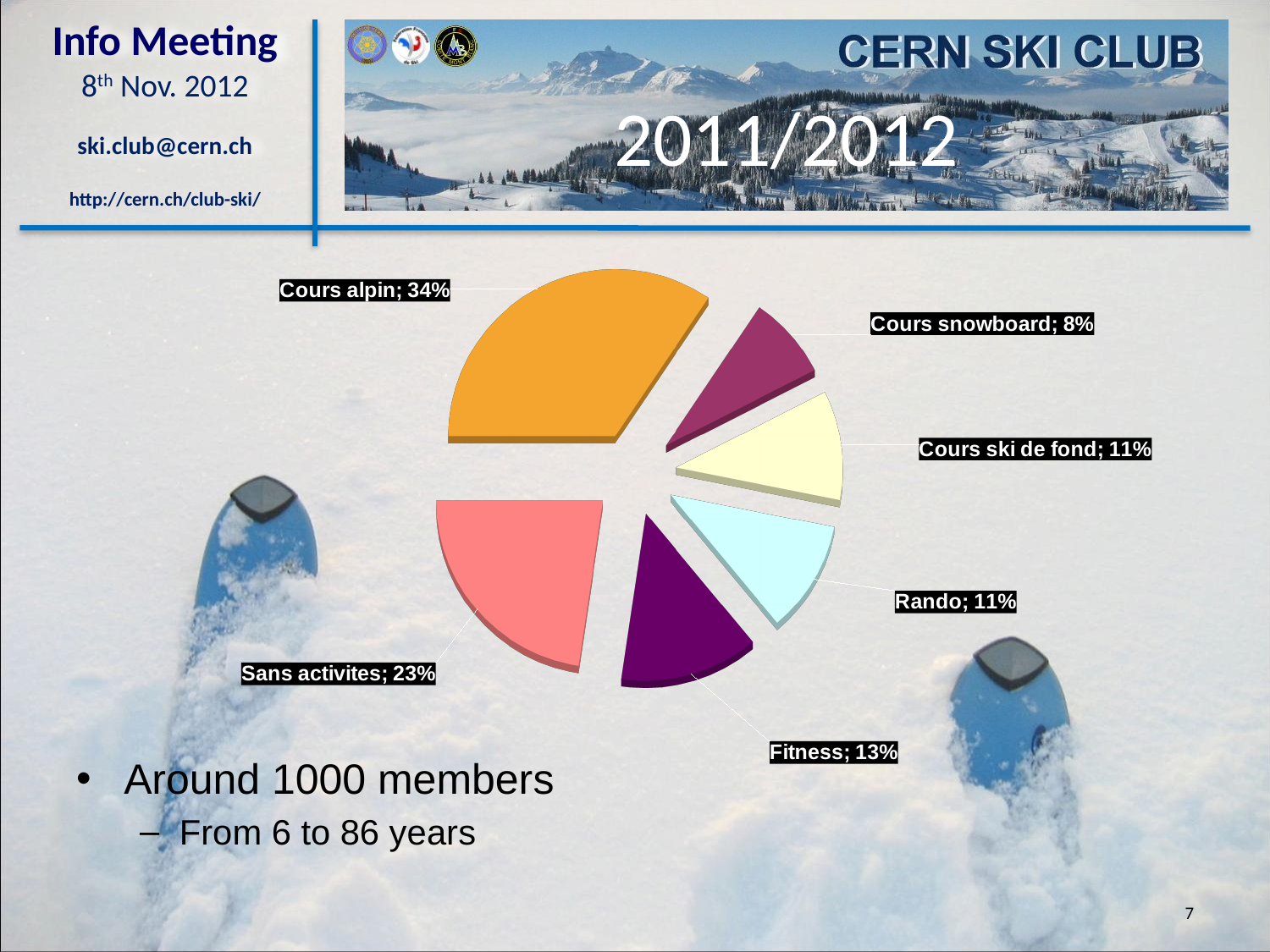
How many slices does the pie chart have? 6 What is the difference in percentage points between Cours alpin and Sans activites? 11 What is the value shown for Sans activites? 23% What kind of chart is shown on the slide? pie chart Which is larger, Fitness or Rando? Fitness What colour is the Cours alpin slice? orange What is the value shown for Fitness? 13% Which category has the largest slice of the pie? Cours alpin What share of the pie does Cours alpin represent? 34% What is the combined share of Cours ski de fond and Rando? 22% What is the value shown for Cours snowboard? 8% Which category has the smallest slice of the pie? Cours snowboard